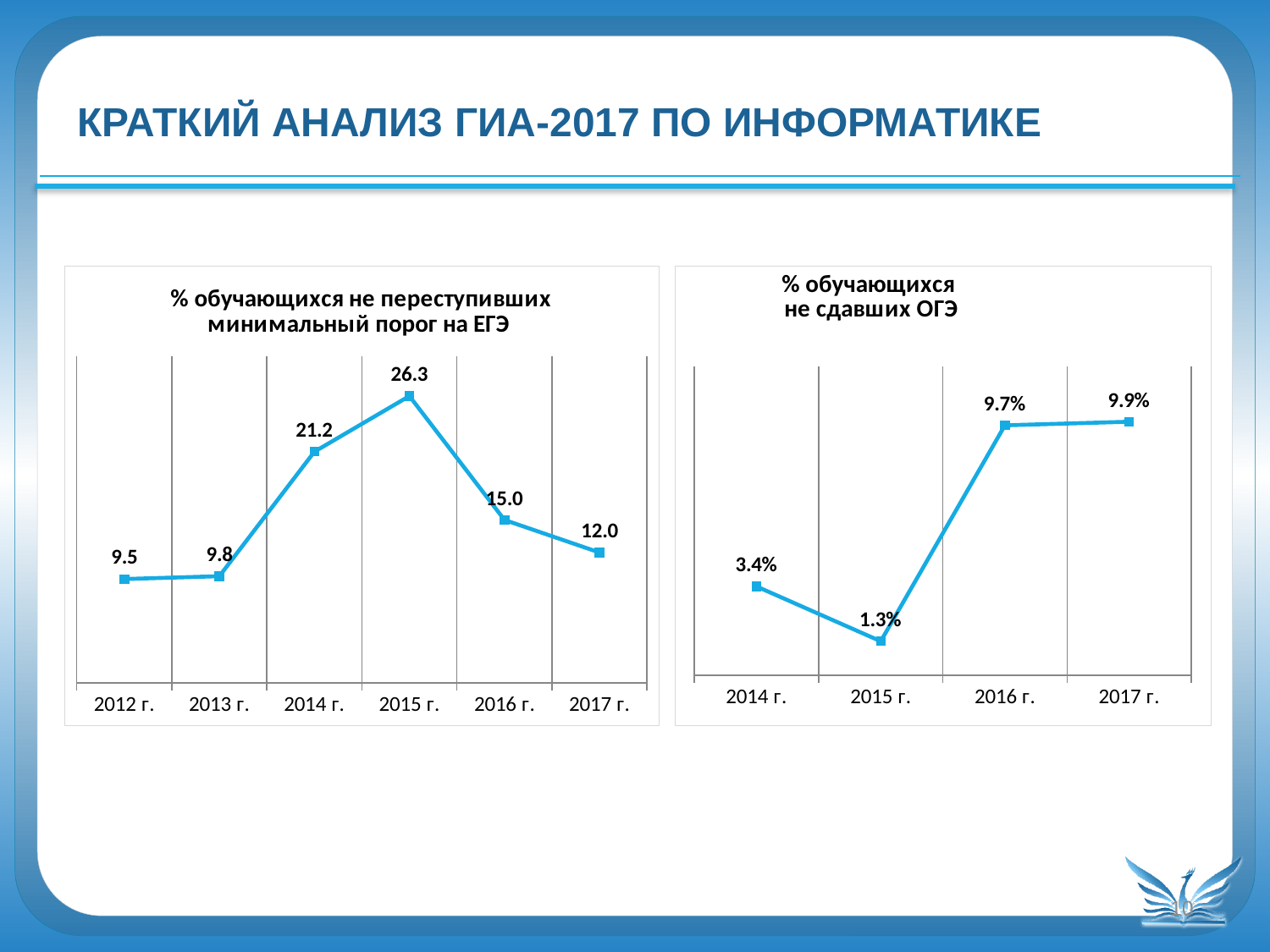
In the left chart (% обучающихся не переступивших минимальный порог на ЕГЭ), how many years are plotted? 6 What kind of chart is the right chart (% обучающихся не сдавших ОГЭ)? line chart In the left chart (% обучающихся не переступивших минимальный порог на ЕГЭ), which year has the highest value? 2015 г. In the left chart (% обучающихся не переступивших минимальный порог на ЕГЭ), do the values rise or fall from 2015 г. to 2017 г.? fall In the right chart (% обучающихся не сдавших ОГЭ), which year has the lowest value? 2015 г. In the left chart (% обучающихся не переступивших минимальный порог на ЕГЭ), what is the value for 2015 г.? 26.3 In the right chart (% обучающихся не сдавших ОГЭ), what is the value for 2016 г.? 9.7% In the left chart (% обучающихся не переступивших минимальный порог на ЕГЭ), what is the difference between the values for 2015 г. and 2017 г.? 14.3 In the left chart (% обучающихся не переступивших минимальный порог на ЕГЭ), what is the value for 2012 г.? 9.5 In the right chart (% обучающихся не сдавших ОГЭ), which is larger, the value for 2014 г. or 2015 г.? 2014 г. In the left chart (% обучающихся не переступивших минимальный порог на ЕГЭ), which year has the lowest value? 2012 г. In the right chart (% обучающихся не сдавших ОГЭ), what is the difference between the values for 2017 г. and 2014 г.? 6.5%